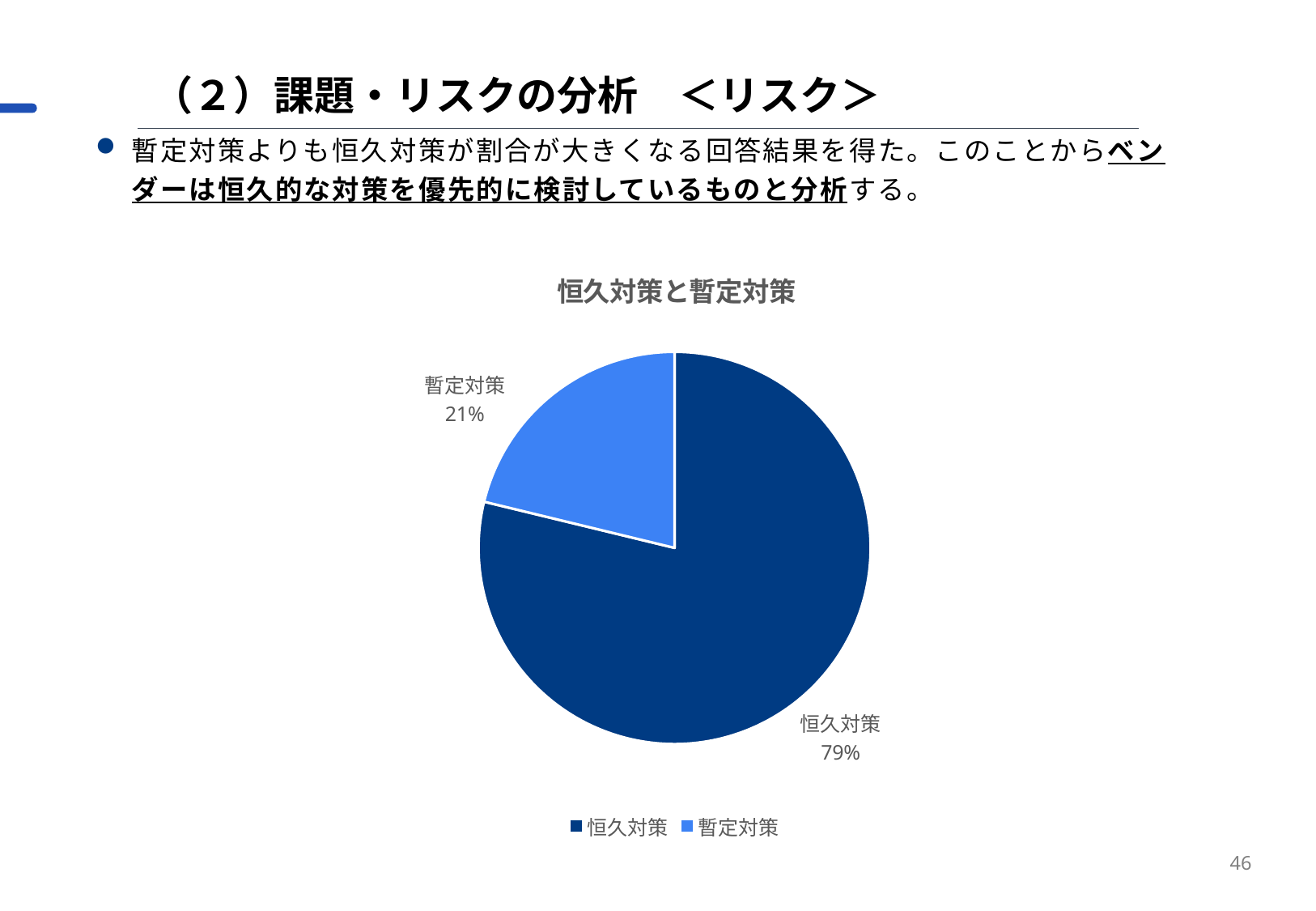
What share of the pie does 暫定対策 represent? 21% How many entries does the legend list? 2 What share of the pie does 恒久対策 represent? 79% What is the title of the chart? 恒久対策と暫定対策 Which is larger, the share for 恒久対策 or the share for 暫定対策? 恒久対策 Which slice is the largest in the pie chart? 恒久対策 What kind of chart is shown on the slide? pie chart How many slices does the pie chart have? 2 What is the difference in percentage points between 恒久対策 and 暫定対策? 58 Which slice is the smallest in the pie chart? 暫定対策 Which legend entry is shown in the lighter blue colour? 暫定対策